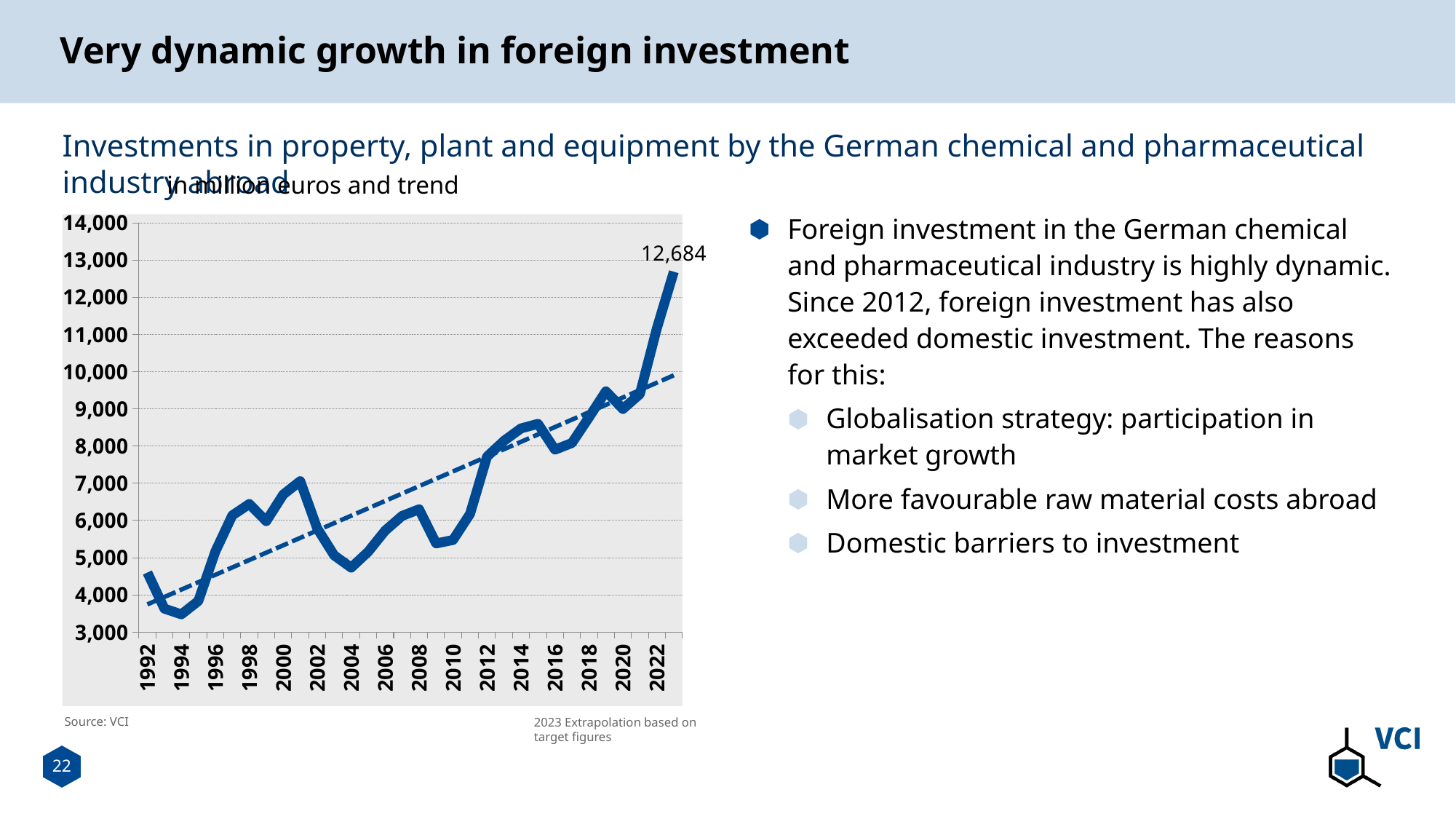
What kind of chart is shown on the slide? line chart Is the value for 1994 greater or less than 4,000? less In what unit are the values on the chart expressed? million euros What is the highest value labelled on the chart? 12,684 How many year labels are shown on the x axis? 16 Is the value for 2000 greater or less than 5,000? greater Is the value for 2014 greater or less than 8,000? greater Do the values generally rise or fall from 1992 to the end of the series? rise What value is printed as a data label at the end of the line? 12,684 Which year has the lowest value on the chart? 1994 Which year has the larger value, 1998 or 2004? 1998